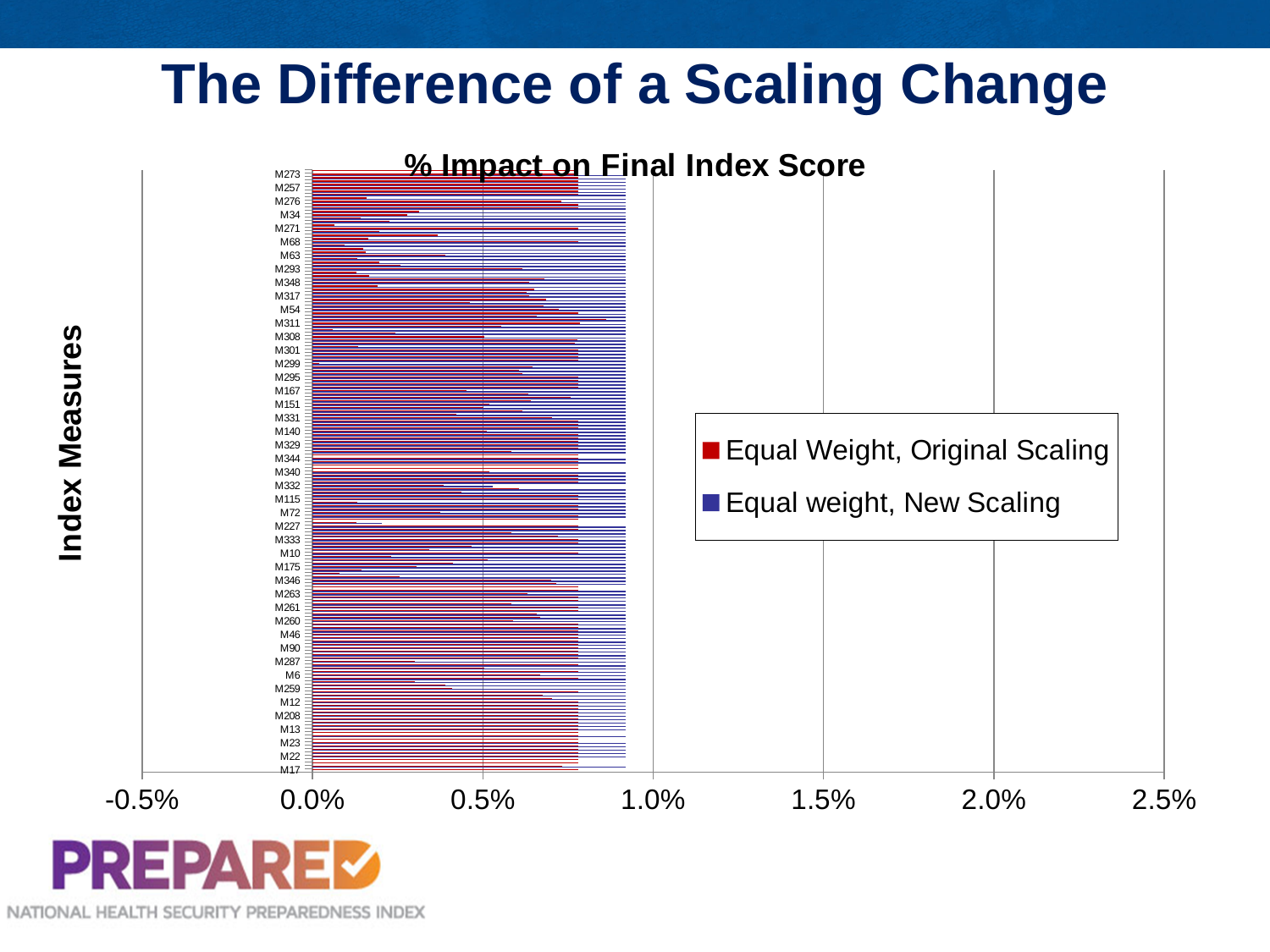
What label is shown on the vertical axis of the chart? Index Measures Is the Equal Weight, Original Scaling value for M63 greater or less than 0.5%? less What is the title of the chart? % Impact on Final Index Score Is the Equal Weight, Original Scaling value for M273 greater or less than 0.5%? greater What is the highest value shown on the horizontal axis? 2.5% Is the Equal weight, New Scaling value for M273 greater or less than 1.0%? less What kind of chart is shown on the slide? Bar chart How many series does the legend list? 2